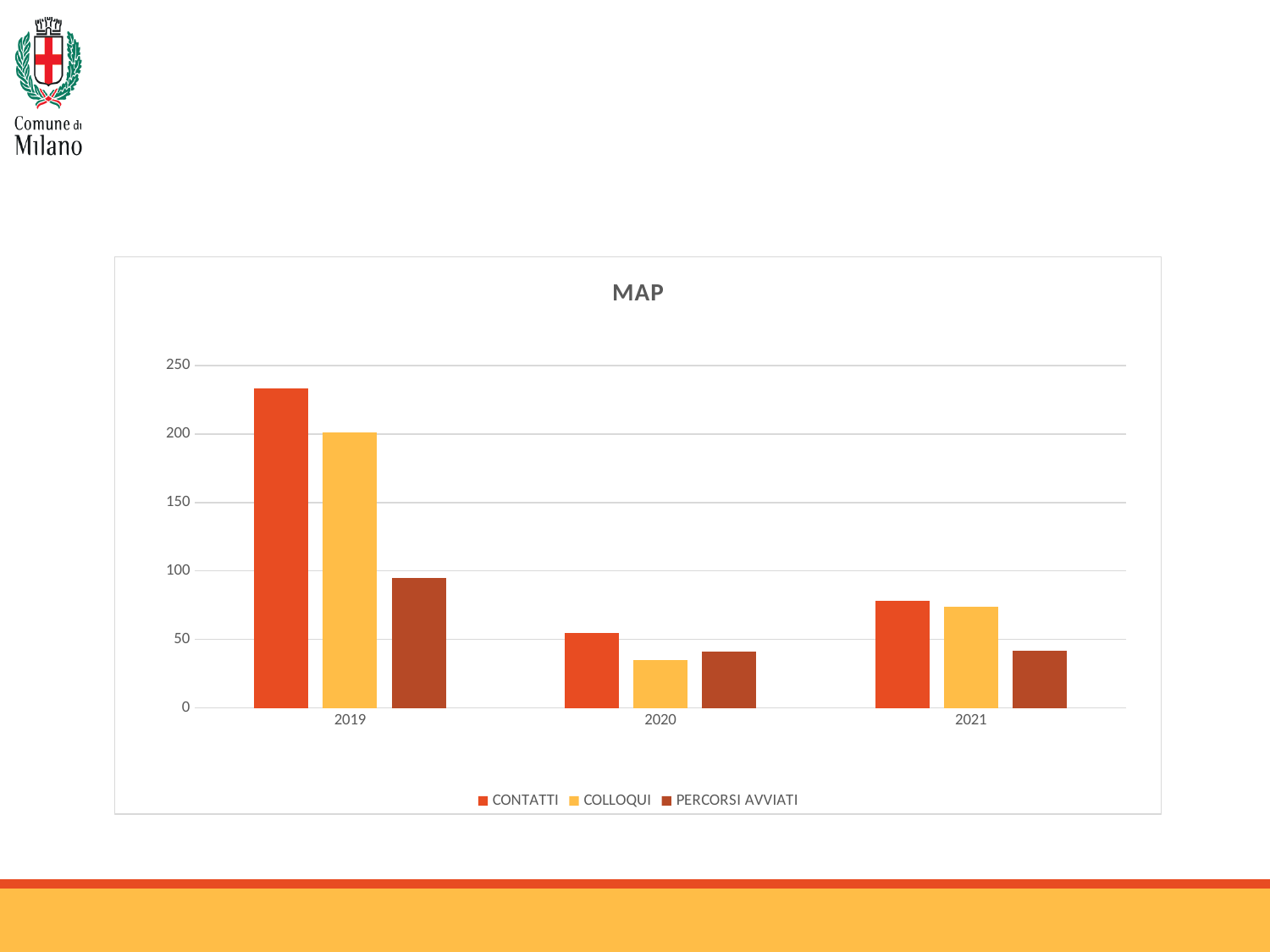
How many series does the legend list? 3 Does the CONTATTI value rise or fall from 2019 to 2020? fall What kind of chart is shown on the slide? bar chart In 2019, which is larger: CONTATTI or PERCORSI AVVIATI? CONTATTI In which year is the COLLOQUI value lowest? 2020 How many years are shown on the x axis? 3 Is the COLLOQUI value for 2020 greater or less than 50? less Which series is shown in yellow in the legend? COLLOQUI Is the CONTATTI value for 2021 greater or less than 100? less In which year is the CONTATTI value highest? 2019 What is the title of the chart? MAP Is the CONTATTI value for 2019 greater or less than 200? greater